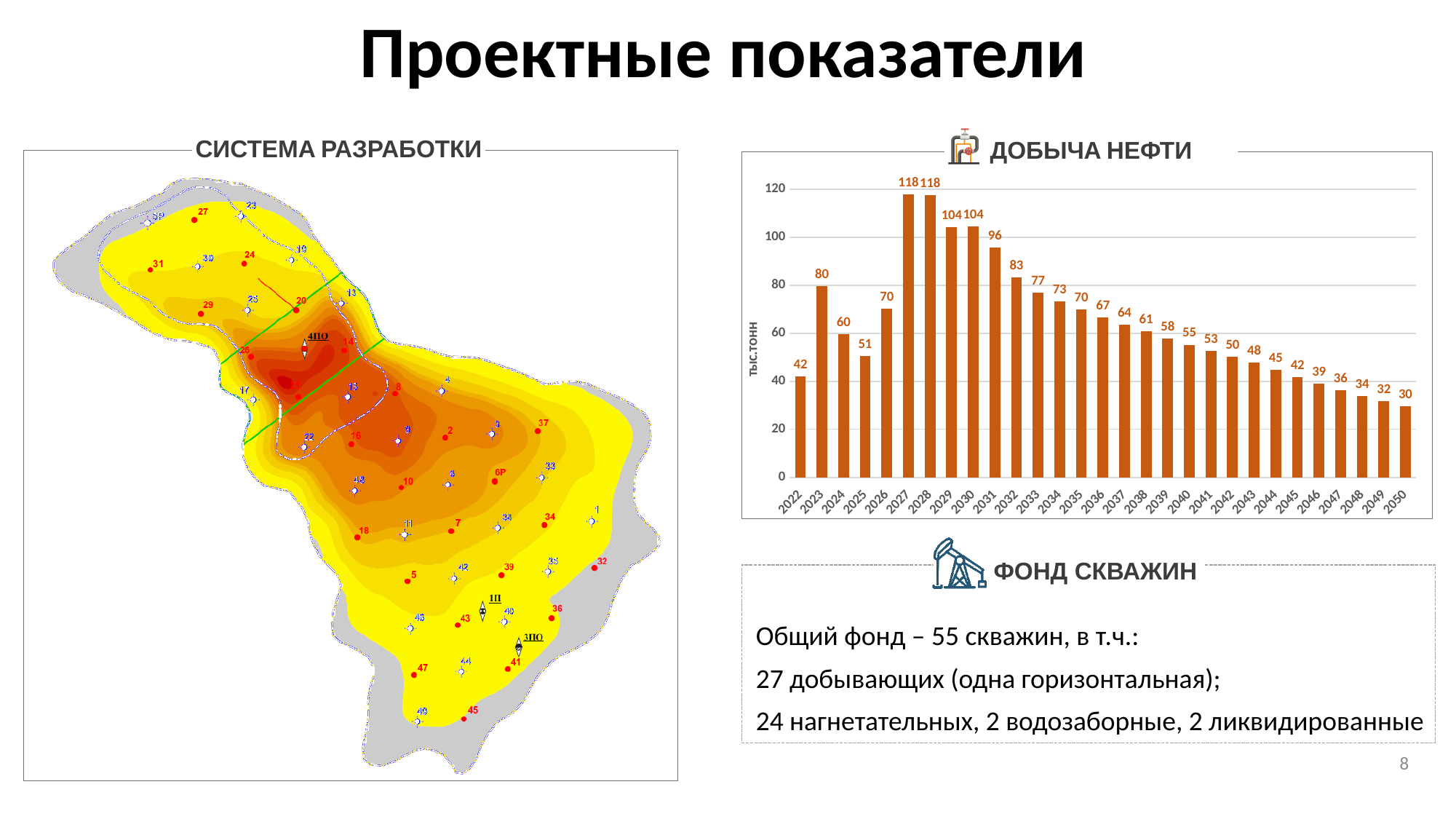
What type of chart is used for "ДОБЫЧА НЕФТИ"? bar chart In the "ДОБЫЧА НЕФТИ" chart, which year has the lowest value? 2050 What unit is shown on the vertical axis of the "ДОБЫЧА НЕФТИ" chart? тыс.тонн In the "ДОБЫЧА НЕФТИ" chart, what is the value for 2031? 96 In the "ДОБЫЧА НЕФТИ" chart, what is the value for 2045? 42 In the "ДОБЫЧА НЕФТИ" chart, what is the highest value shown? 118 In the "ДОБЫЧА НЕФТИ" chart, what is the value for 2022? 42 In the "ДОБЫЧА НЕФТИ" chart, what is the difference between the values for 2029 and 2032? 21 In the "ДОБЫЧА НЕФТИ" chart, what is the difference between the values for 2023 and 2024? 20 In the "ДОБЫЧА НЕФТИ" chart, do the values rise or fall from 2028 to 2050? fall In the "ДОБЫЧА НЕФТИ" chart, which is larger, the value for 2025 or the value for 2026? 2026 In the "ДОБЫЧА НЕФТИ" chart, how many years are plotted? 29